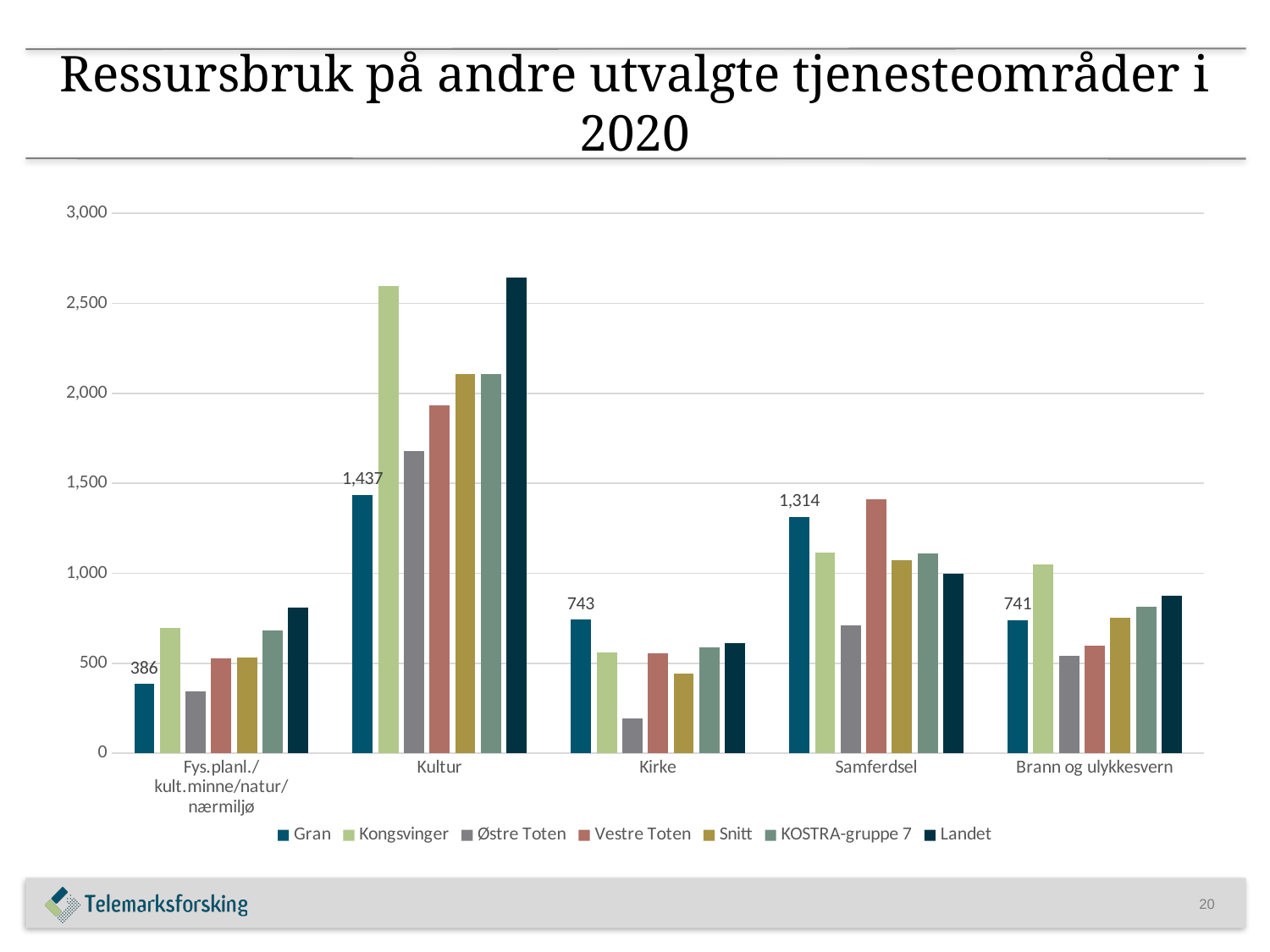
What is the difference between Gran's value for Kultur and Gran's value for Samferdsel? 123 What is the value for Gran in the Brann og ulykkesvern category? 741 Is the value for Østre Toten in the Kirke category greater or less than 500? less In the Kultur category, which is larger: the value for Gran or the value for Kongsvinger? Kongsvinger What is the value for Gran in the Kultur category? 1,437 What is the value for Gran in the Fys.planl./kult.minne/natur/nærmiljø category? 386 How many series does the legend list? 7 How many categories are shown on the x axis? 5 In which category does Gran have its highest value? Kultur What kind of chart is shown on the slide? bar chart In which category does Gran have its lowest value? Fys.planl./kult.minne/natur/nærmiljø What is the value for Gran in the Samferdsel category? 1,314